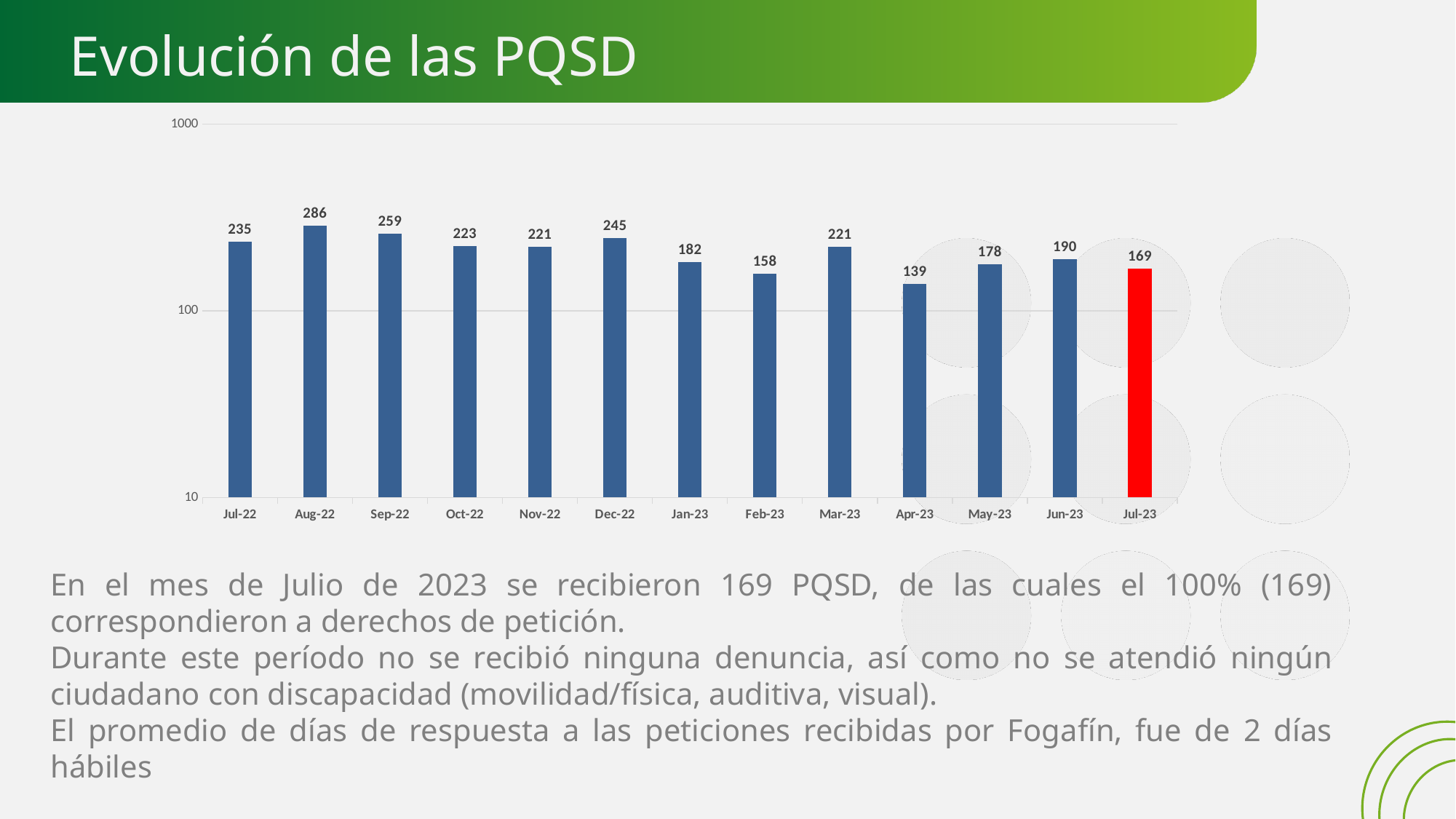
Which is larger, the value for Sep-22 or the value for Dec-22? Sep-22 Which month has the highest value? Aug-22 Which bar is coloured red? Jul-23 What is the value for Jul-23? 169 What is the value for Aug-22? 286 Do the values rise or fall from Apr-23 to Jun-23? rise What kind of chart is shown on the slide? bar chart How many months are shown on the x axis? 13 What is the difference between the values for Jun-23 and Jul-23? 21 Which month has the lowest value? Apr-23 What is the value for Feb-23? 158 Is the value for Apr-23 greater or less than 100? greater